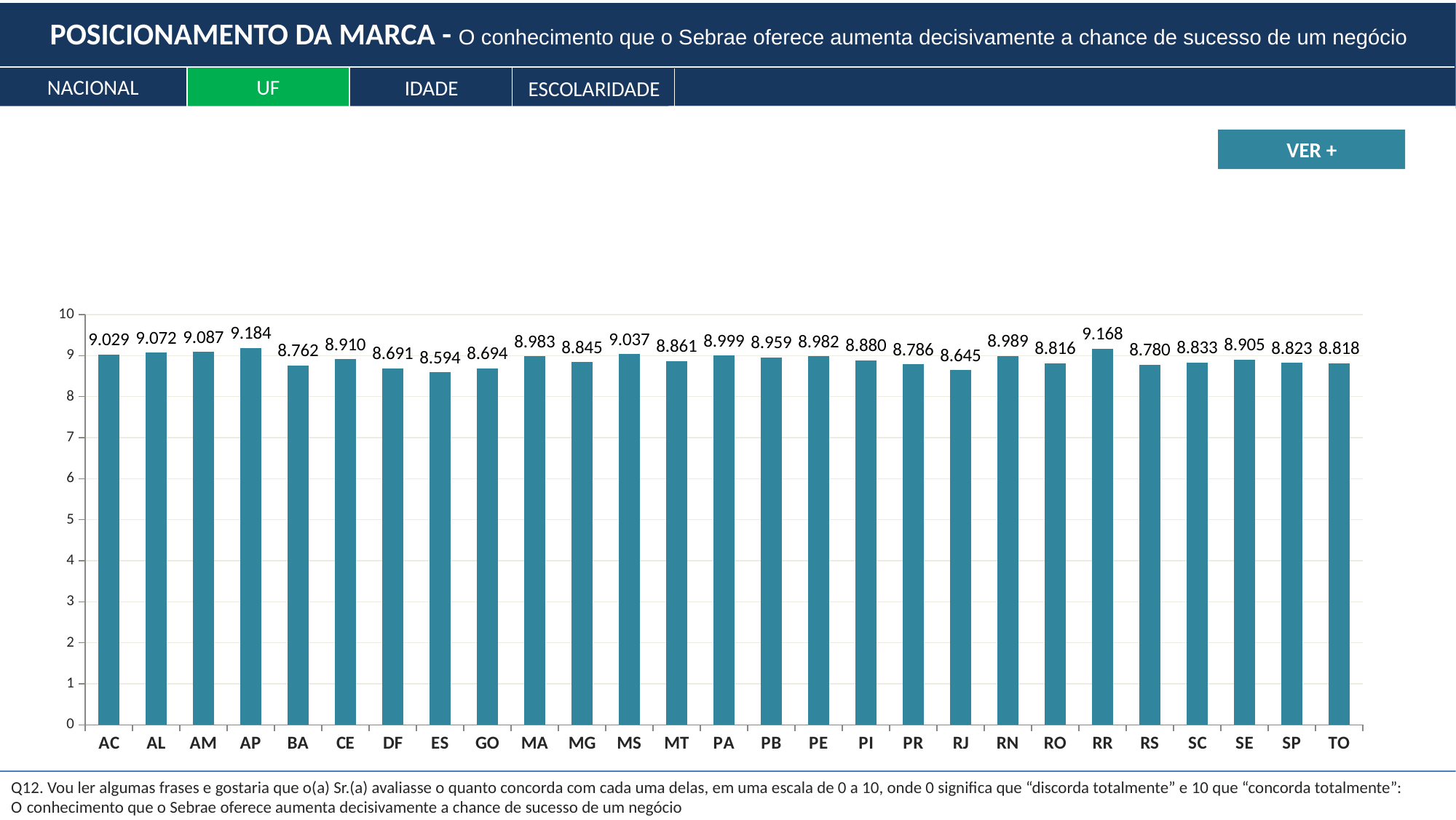
What is the difference between the values for AL and AC? 0.043 Which tab is highlighted in green at the top of the slide? UF How many UFs are shown on the x axis? 27 What is the value for ES? 8.594 What kind of chart is shown on the slide? bar chart What is the value for SP? 8.823 Which UF has the highest value? AP What is the difference between the values for AP and ES? 0.590 Which UF has the lowest value? ES Which has a larger value, MS or MG? MS What is the value for RR? 9.168 Is the value for RJ greater or less than 9? less